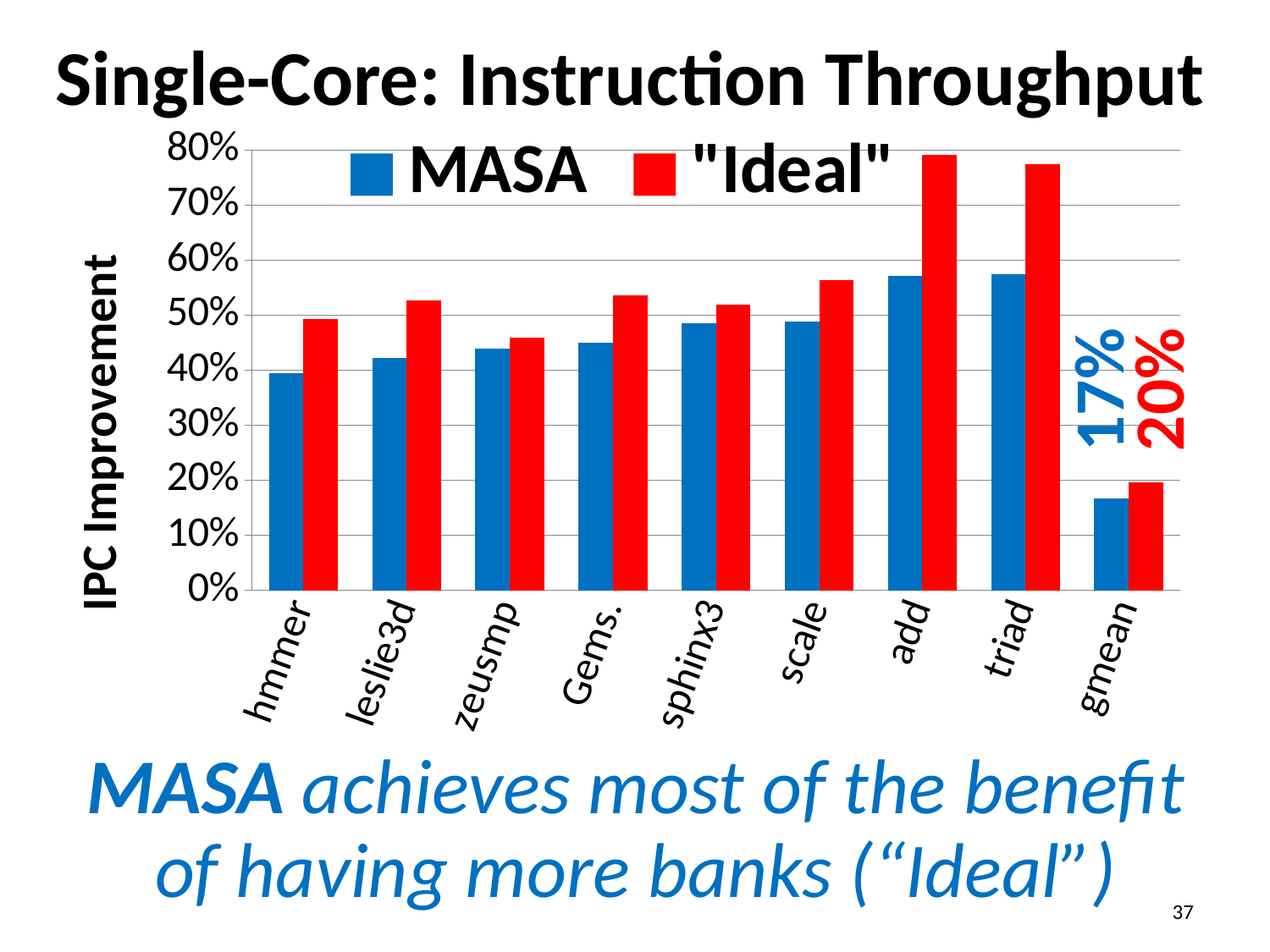
How many categories are shown on the x axis? 9 What is the difference between the "Ideal" and MASA values for gmean? 3 percentage points Which is larger, the "Ideal" value for add or the "Ideal" value for hmmer? add Excluding gmean, which benchmark has the lowest "Ideal" value? zeusmp What is the label on the y axis? IPC Improvement What kind of chart is shown on the slide? Bar chart What is the MASA value for gmean? 17% How many series does the legend list? 2 Excluding gmean, which benchmark has the lowest MASA value? hmmer Is the "Ideal" value for zeusmp greater or less than 50%? less Is the "Ideal" value for add greater or less than 70%? greater What is the "Ideal" value for gmean? 20%